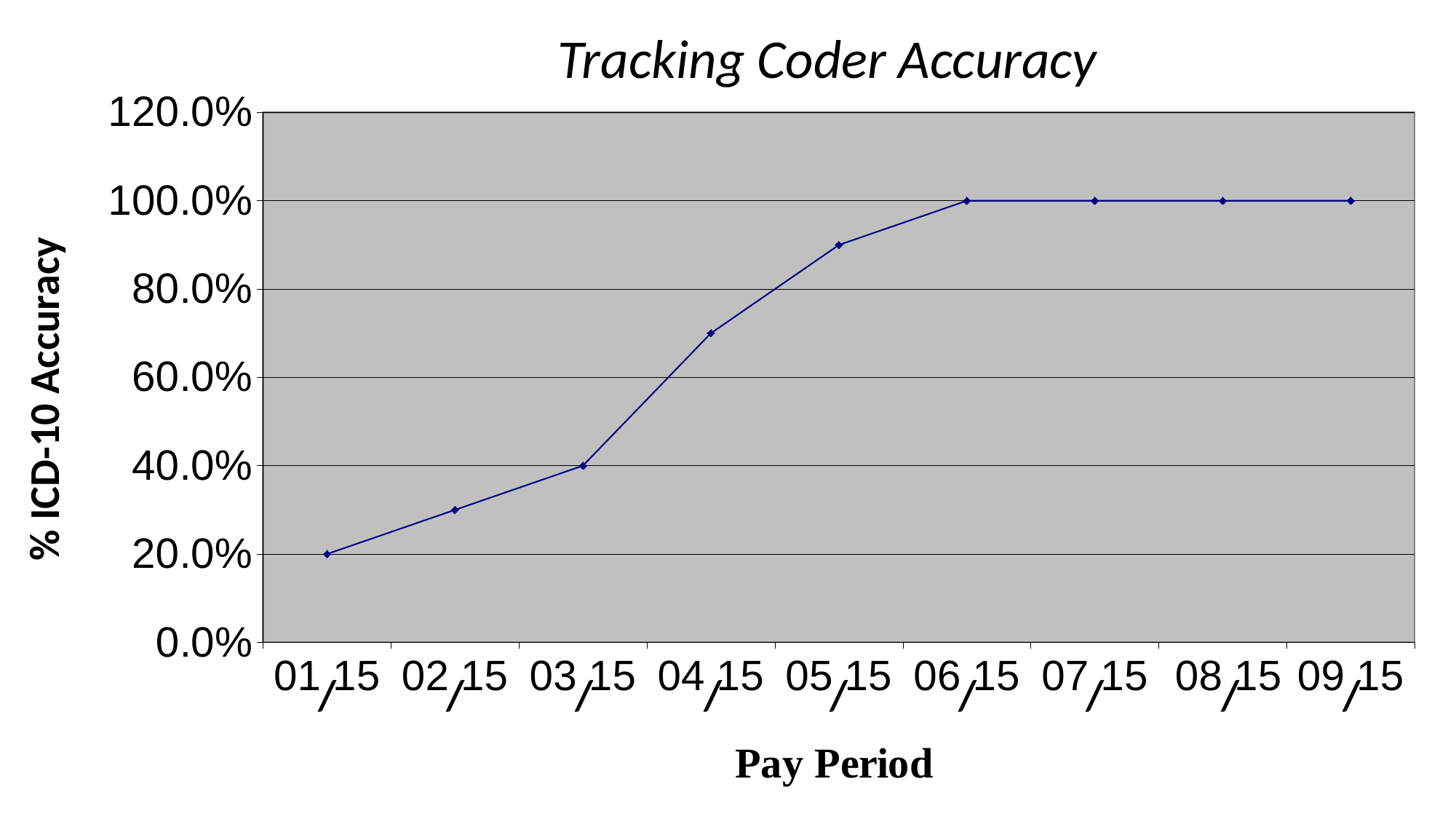
What is the % ICD-10 Accuracy for pay period 03/15? 40.0% Is the value for pay period 04/15 greater or less than 60.0%? greater Is the value for pay period 02/15 greater or less than 40.0%? less What is the % ICD-10 Accuracy for pay period 09/15? 100.0% What is the title of the chart? Tracking Coder Accuracy What is the % ICD-10 Accuracy for pay period 06/15? 100.0% What is the label of the x axis? Pay Period Which pay period has the lowest % ICD-10 Accuracy? 01/15 How many pay periods are plotted on the x axis? 9 What is the % ICD-10 Accuracy for pay period 01/15? 20.0% Does the % ICD-10 Accuracy rise or fall from 01/15 to 06/15? rise What kind of chart is shown on the slide? line chart